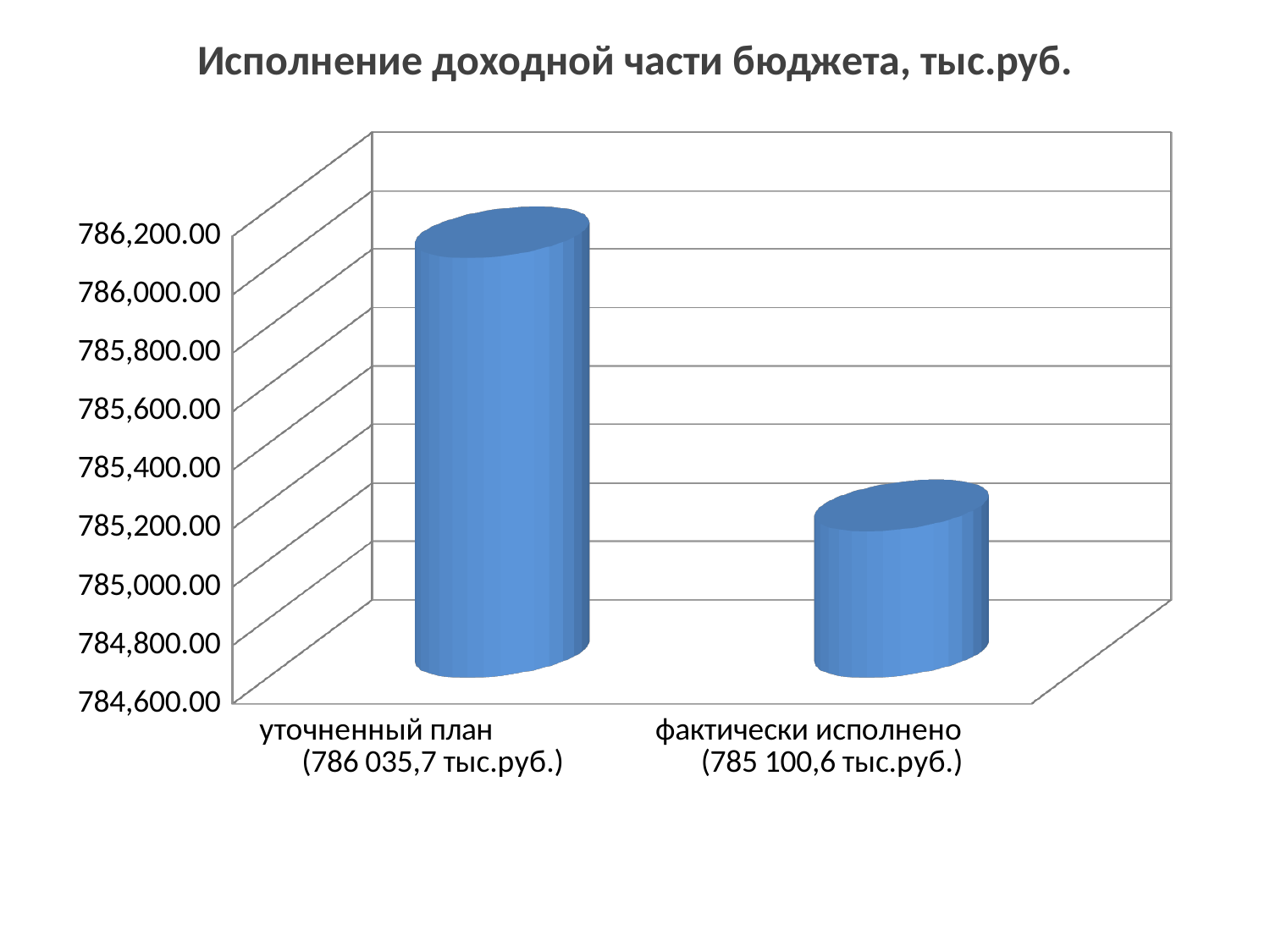
How many categories are shown in the chart? 2 Do the values rise or fall from left to right along the x axis? fall Is the value for уточненный план greater or less than 785,800.00? greater What kind of chart is shown on the slide? bar chart What is the value for уточненный план? 786 035,7 тыс.руб. Which category has the lowest value? фактически исполнено Is the value for фактически исполнено greater or less than 785,400.00? less What is the title of the chart? Исполнение доходной части бюджета, тыс.руб. Which is larger, уточненный план or фактически исполнено? уточненный план Which category has the highest value? уточненный план What is the value for фактически исполнено? 785 100,6 тыс.руб. What is the difference between уточненный план and фактически исполнено? 935,1 тыс.руб.